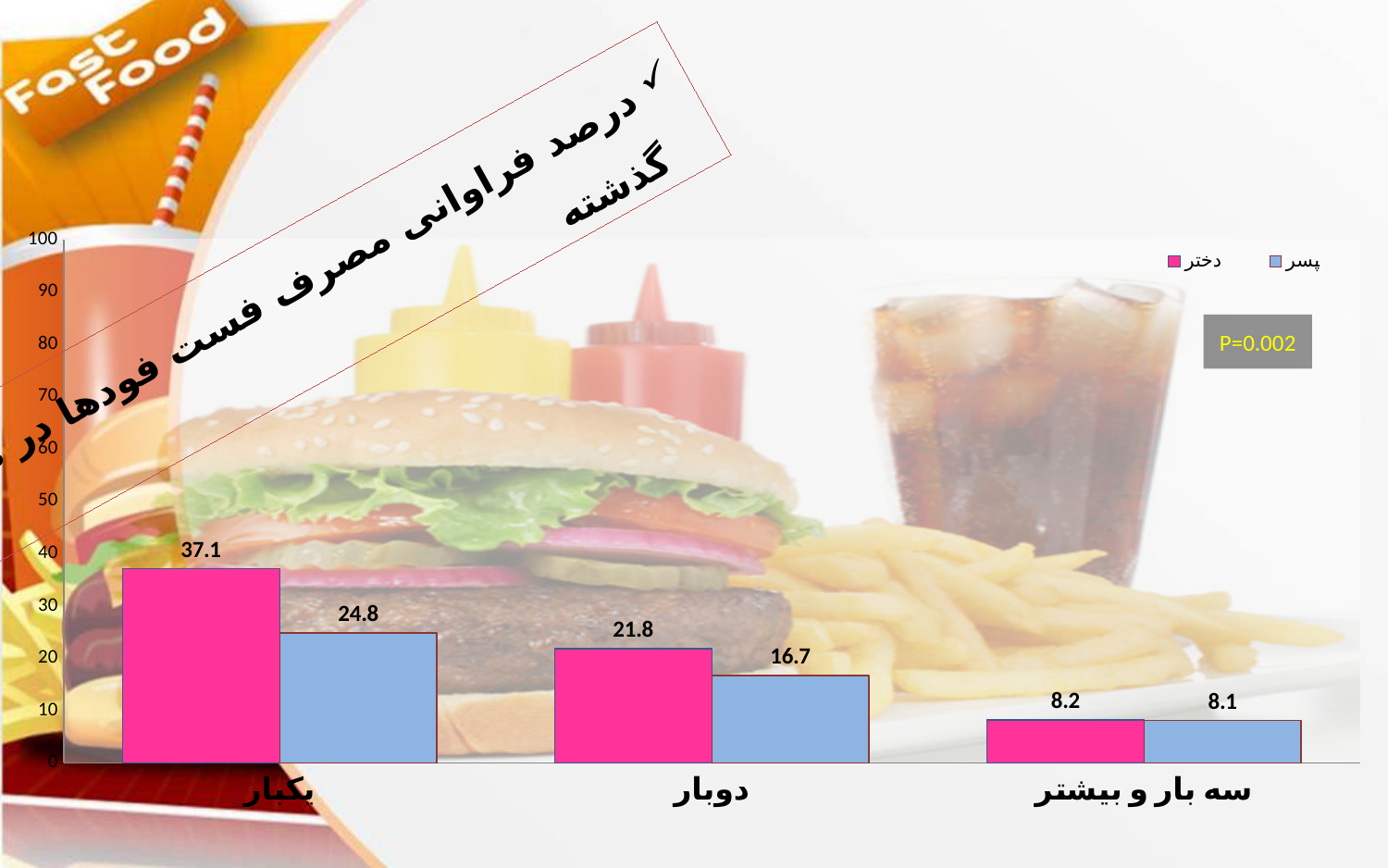
What is the value for دختر in the یکبار category? 37.1 In the دوبار category, which series has the larger value, دختر or پسر? دختر Which category has the lowest value for دختر? سه بار و بیشتر What is the difference between the دختر and پسر values in the یکبار category? 12.3 What is the value for دختر in the سه بار و بیشتر category? 8.2 What is the value for پسر in the دوبار category? 16.7 Which category has the highest value for پسر? یکبار What P value is shown in the box on the chart? P=0.002 What kind of chart is shown on the slide? bar chart How many series does the legend list? 2 What is the difference between the دختر values for یکبار and دوبار? 15.3 How many categories are shown on the x axis? 3